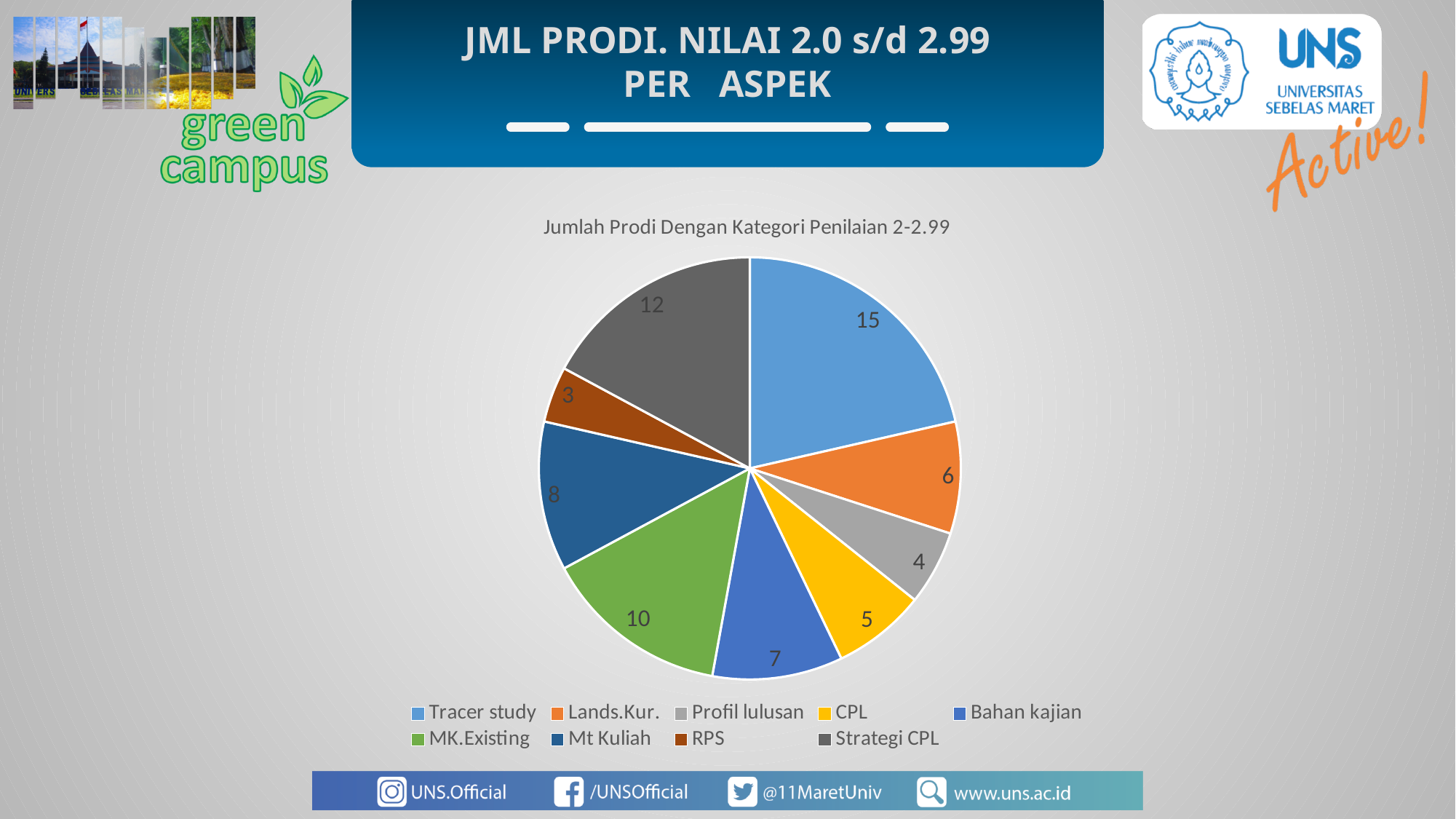
What is the chart title shown above the pie? Jumlah Prodi Dengan Kategori Penilaian 2-2.99 What is the value for Tracer study? 15 Which category has the smallest slice? RPS What is the value for Strategi CPL? 12 How many categories does the legend list? 9 What is the difference between the values for Tracer study and Strategi CPL? 3 Which is larger, the value for Mt Kuliah or the value for Bahan kajian? Mt Kuliah What is the value for RPS? 3 Which category has the largest slice? Tracer study What type of chart is shown on the slide? pie chart What is the total of all the slice values in the pie? 70 What is the value for MK.Existing? 10